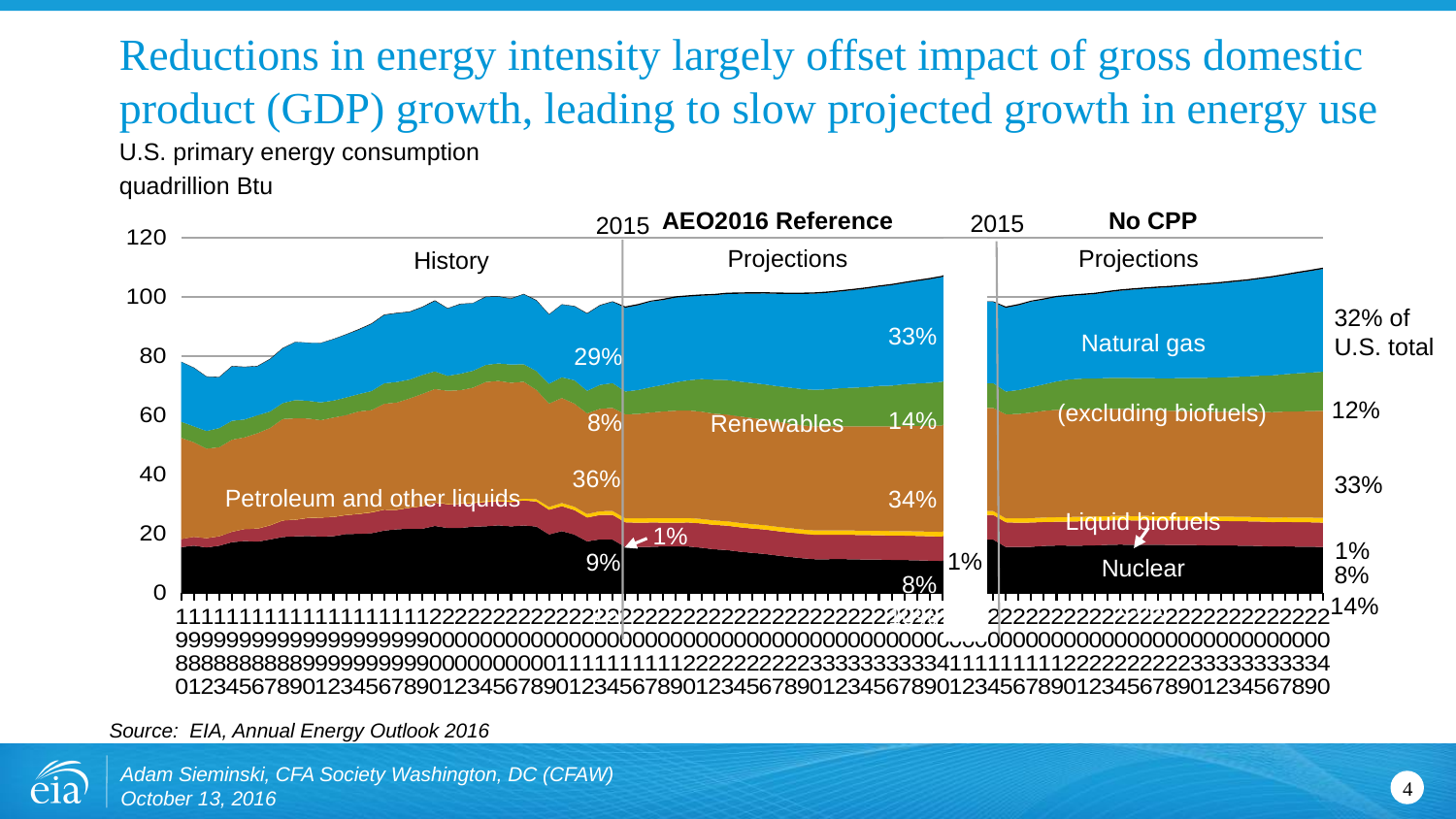
Which is larger: the natural gas share at the end of the AEO2016 Reference projection or at the end of the No CPP projection? AEO2016 Reference What kind of chart is shown on the slide? Stacked area chart In the AEO2016 Reference panel, what share is labeled for natural gas at the end of the projection? 33% Is total U.S. primary energy consumption at the end of the AEO2016 Reference projection greater or less than 100 quadrillion Btu? greater What unit is U.S. primary energy consumption measured in on the chart? quadrillion Btu What share is labeled for natural gas in 2015? 29% In the AEO2016 Reference panel, what share is labeled for renewables at the end of the projection? 14% In the No CPP panel, what share of the U.S. total does natural gas account for at the end of the projection? 32% In the No CPP panel, what share is labeled for renewables (excluding biofuels) at the end of the projection? 12% What are the titles of the two projection panels on the chart? AEO2016 Reference and No CPP By how many percentage points does the renewables share at the end of the AEO2016 Reference projection (14%) exceed the renewables share at the end of the No CPP projection (12%)? 2 percentage points What share is labeled for petroleum and other liquids in 2015? 36%